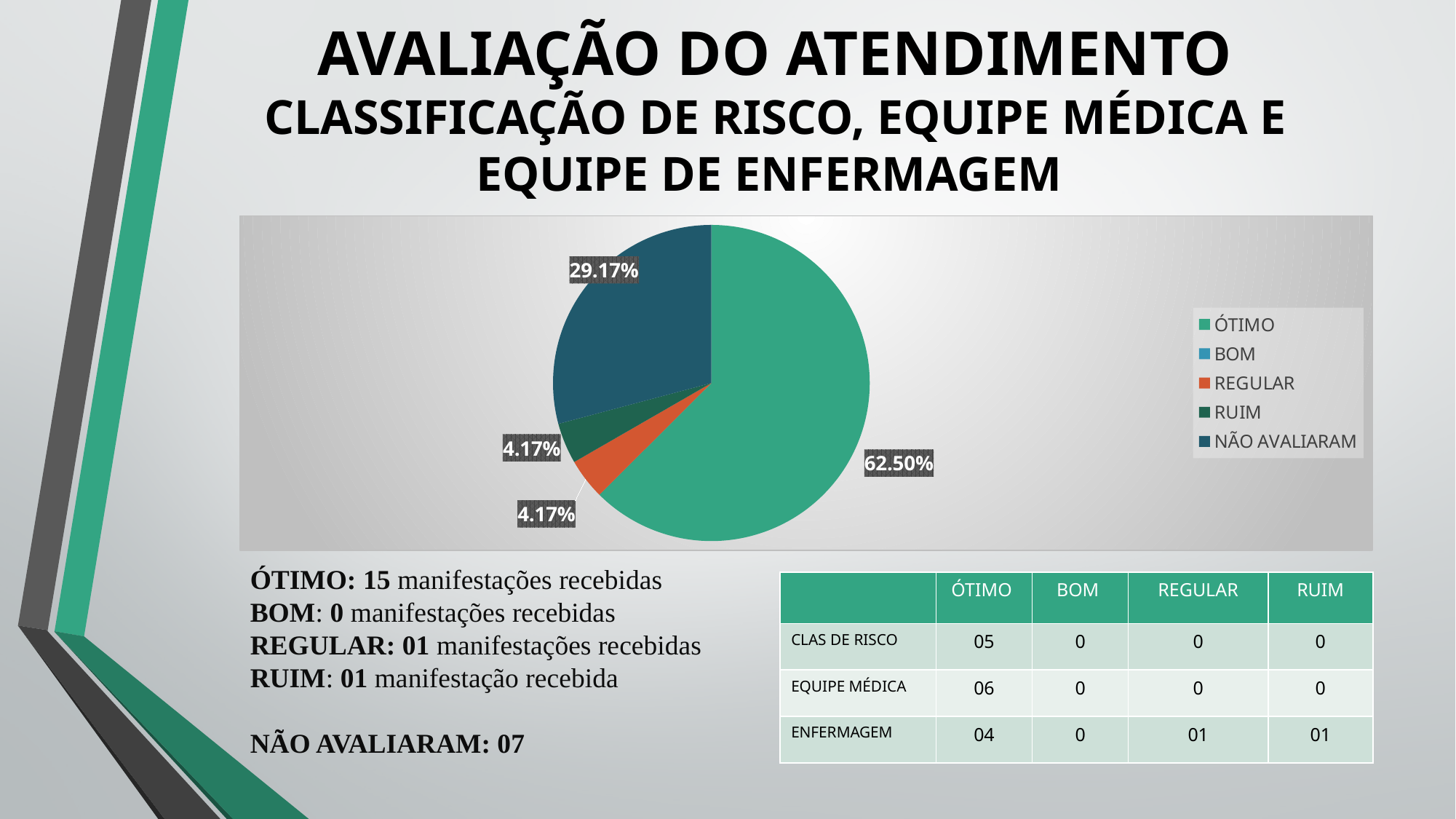
What is the difference in percentage points between the ÓTIMO slice and the NÃO AVALIARAM slice? 33.33% What colour is used for the ÓTIMO slice in the pie chart? green Which is larger, the slice for ÓTIMO or the slice for NÃO AVALIARAM? ÓTIMO What share of the pie does ÓTIMO represent? 62.50% What share of the pie does REGULAR represent? 4.17% What share of the pie does NÃO AVALIARAM represent? 29.17% Which category has the largest slice of the pie? ÓTIMO How many slices with a percentage label are shown in the pie chart? 4 What kind of chart is shown on the slide? pie chart How many entries does the legend of the pie chart list? 5 Which legend entry has no visible slice in the pie chart? BOM